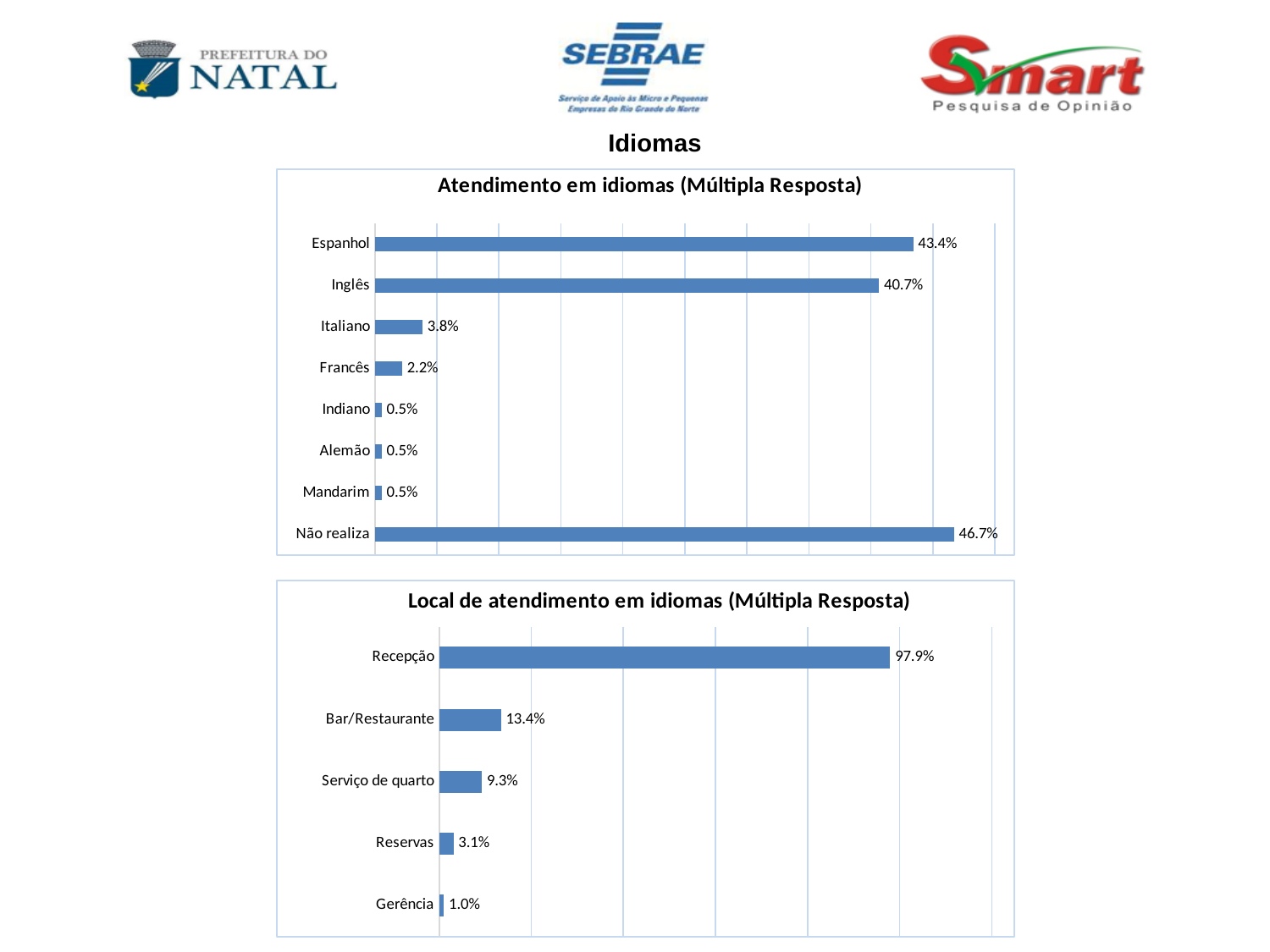
In the 'Local de atendimento em idiomas (Múltipla Resposta)' chart, what is the value for Recepção? 97.9% In the 'Local de atendimento em idiomas (Múltipla Resposta)' chart, which category has the lowest value? Gerência How many categories are shown in the 'Local de atendimento em idiomas (Múltipla Resposta)' chart? 5 How many categories are shown in the 'Atendimento em idiomas (Múltipla Resposta)' chart? 8 In the 'Local de atendimento em idiomas (Múltipla Resposta)' chart, what is the difference between Bar/Restaurante and Serviço de quarto? 4.1% In the 'Atendimento em idiomas (Múltipla Resposta)' chart, which category has the highest value? Não realiza In the 'Atendimento em idiomas (Múltipla Resposta)' chart, which is larger, Italiano or Francês? Italiano What kind of chart is the 'Local de atendimento em idiomas (Múltipla Resposta)' chart? Bar chart In the 'Atendimento em idiomas (Múltipla Resposta)' chart, what is the value for Inglês? 40.7% In the 'Atendimento em idiomas (Múltipla Resposta)' chart, what is the difference between Espanhol and Inglês? 2.7% In the 'Atendimento em idiomas (Múltipla Resposta)' chart, what is the value for Espanhol? 43.4% What is the title of the top chart on the slide? Atendimento em idiomas (Múltipla Resposta)